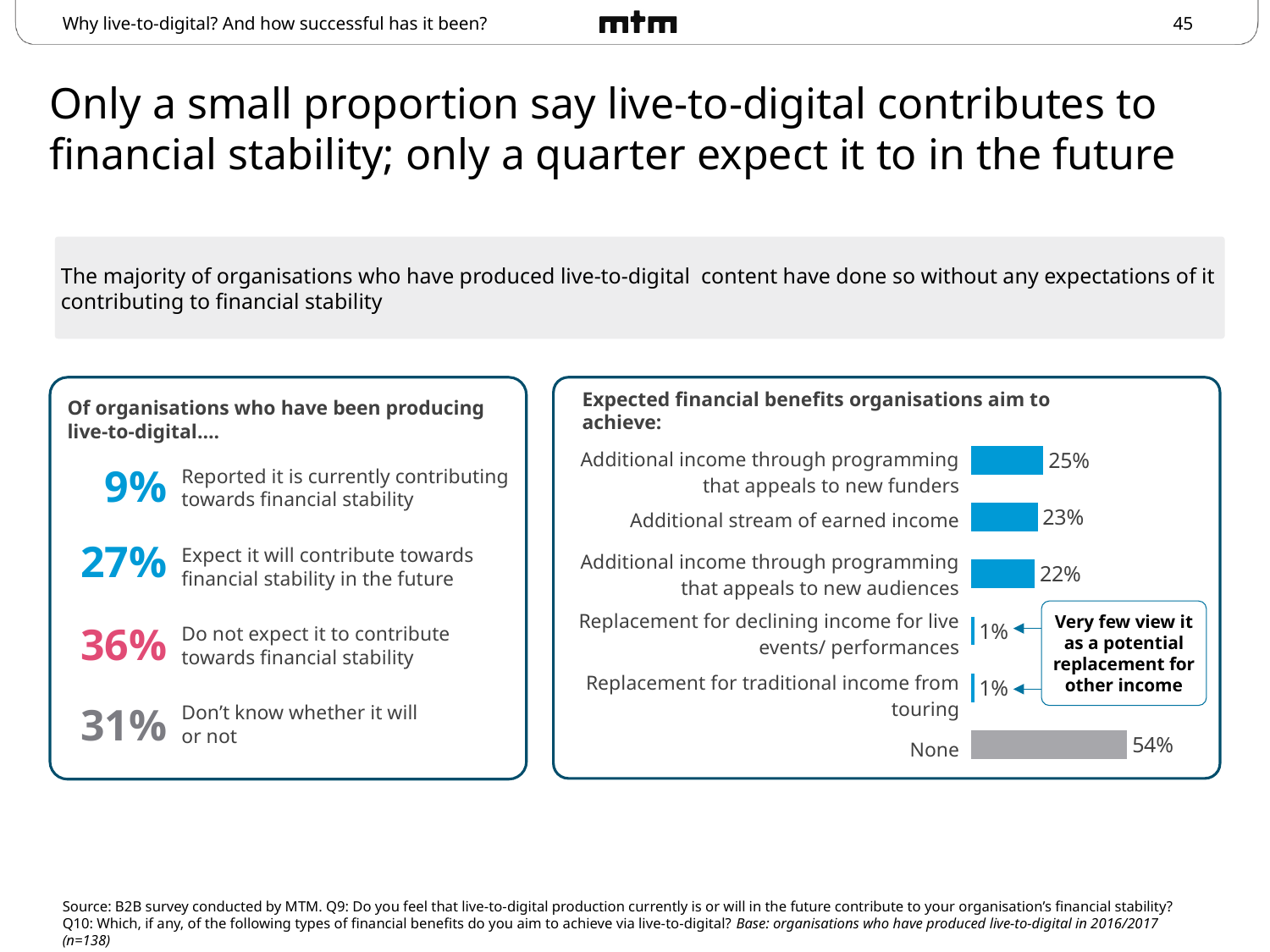
In the chart 'Expected financial benefits organisations aim to achieve', what is the value for 'Additional stream of earned income'? 23% In the chart 'Expected financial benefits organisations aim to achieve', how many categories have a value of 1%? 2 In the chart 'Expected financial benefits organisations aim to achieve', what is the difference between 'None' and 'Additional income through programming that appeals to new funders'? 29% In the chart 'Expected financial benefits organisations aim to achieve', what is the value for 'Additional income through programming that appeals to new audiences'? 22% In the chart 'Expected financial benefits organisations aim to achieve', which category has the highest value? None In the chart 'Expected financial benefits organisations aim to achieve', which bar is coloured grey rather than blue? None In the chart 'Expected financial benefits organisations aim to achieve', what is the value for 'Replacement for traditional income from touring'? 1% What type of chart is 'Expected financial benefits organisations aim to achieve'? Bar chart How many categories are shown in the chart 'Expected financial benefits organisations aim to achieve'? 6 In the chart 'Expected financial benefits organisations aim to achieve', which is larger: 'Additional stream of earned income' or 'Additional income through programming that appeals to new audiences'? Additional stream of earned income In the chart 'Expected financial benefits organisations aim to achieve', what is the value for 'None'? 54% In the chart 'Expected financial benefits organisations aim to achieve', what is the difference between 'Additional income through programming that appeals to new funders' and 'Additional stream of earned income'? 2%